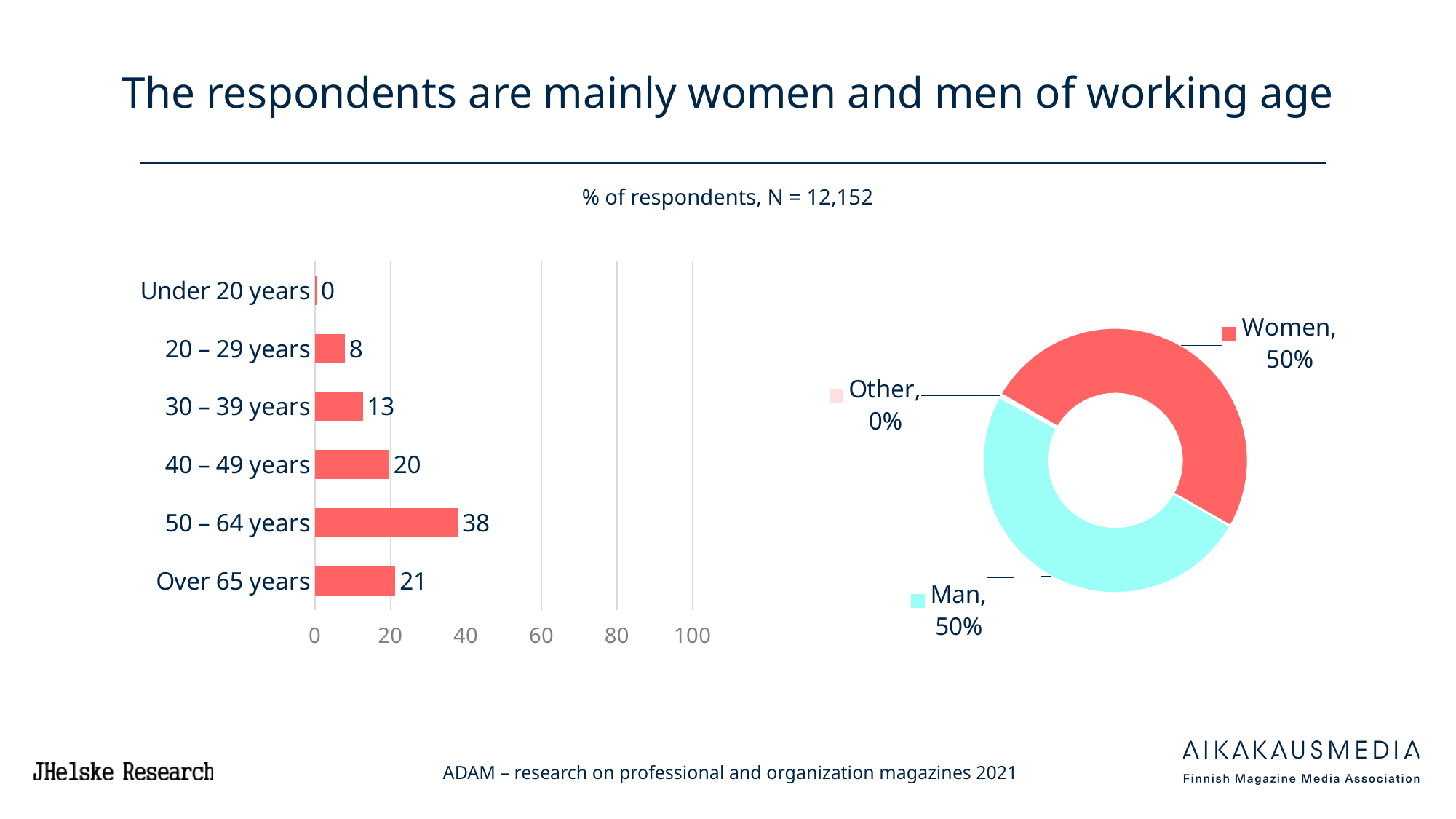
In the bar chart on the left, what is the value for 50 – 64 years? 38 In the bar chart on the left, what is the value for 30 – 39 years? 13 In the doughnut chart on the right, how many categories are shown? 3 What is the subtitle shown above the charts? % of respondents, N = 12,152 What kind of chart is shown on the left of the slide? Bar chart In the bar chart on the left, how many age groups are shown? 6 In the bar chart on the left, which age group has the lowest value? Under 20 years In the bar chart on the left, which is larger: the value for 40 – 49 years or the value for Over 65 years? Over 65 years In the bar chart on the left, which age group has the highest value? 50 – 64 years In the bar chart on the left, what is the difference between the values for 50 – 64 years and Over 65 years? 17 In the doughnut chart on the right, what is the share for Women? 50% In the doughnut chart on the right, what is the share for Other? 0%